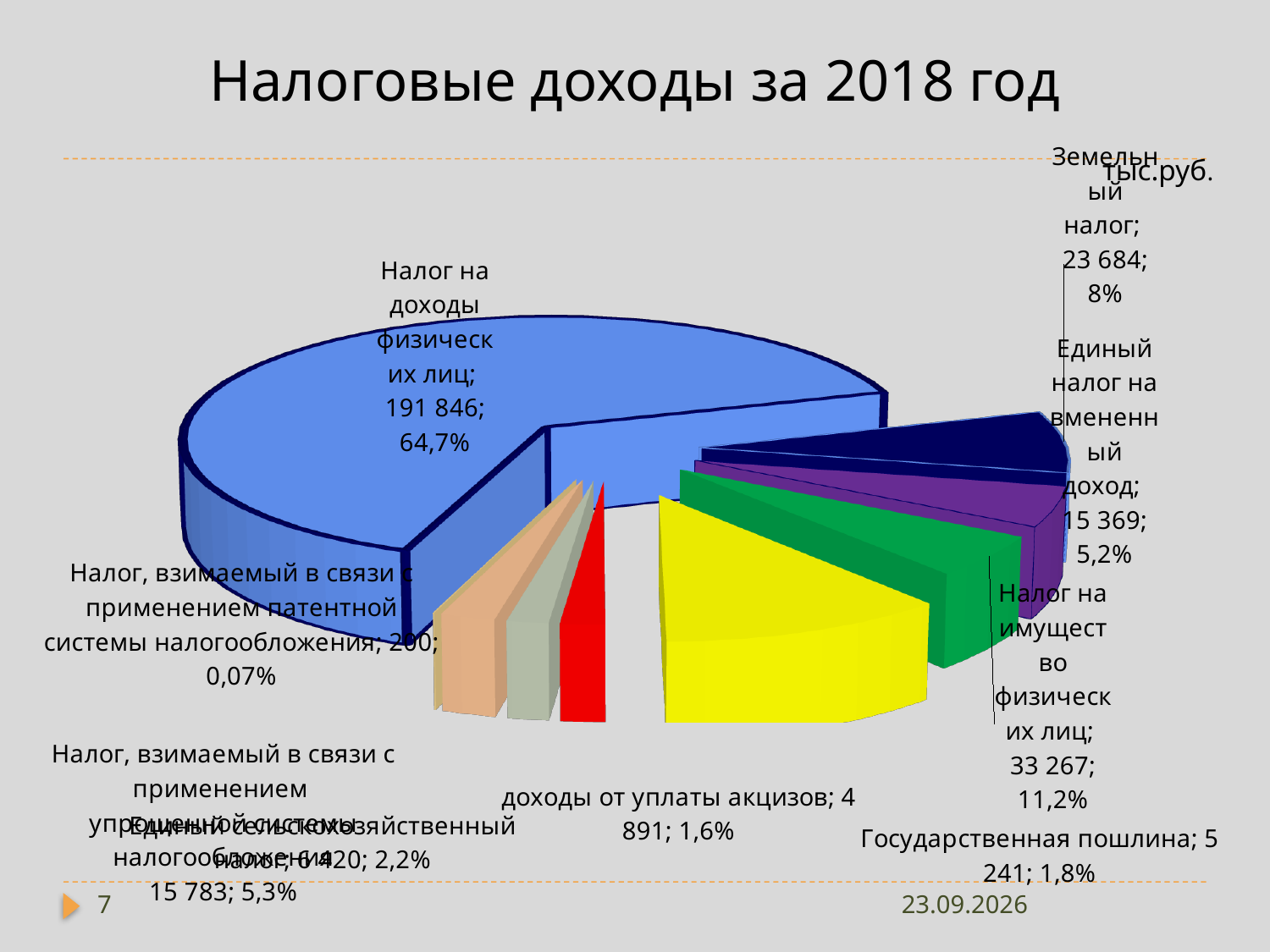
Which category has the largest slice of the pie? Налог на доходы физических лиц What is the value for Земельный налог? 23 684 What is the difference between the values for Налог на доходы физических лиц and Налог на имущество физических лиц? 158 579 What is the title of the chart on the slide? Налоговые доходы за 2018 год Which category has the smallest slice of the pie? Налог, взимаемый в связи с применением патентной системы налогообложения What is the value for Государственная пошлина? 5 241 How many categories are shown in the pie chart? 9 Which is larger: Земельный налог or Единый налог на вмененный доход? Земельный налог What share of the pie does Налог на доходы физических лиц represent? 64,7% What kind of chart is shown on the slide? pie chart What share of the pie does Налог на имущество физических лиц represent? 11,2% What is the value for Налог на доходы физических лиц? 191 846